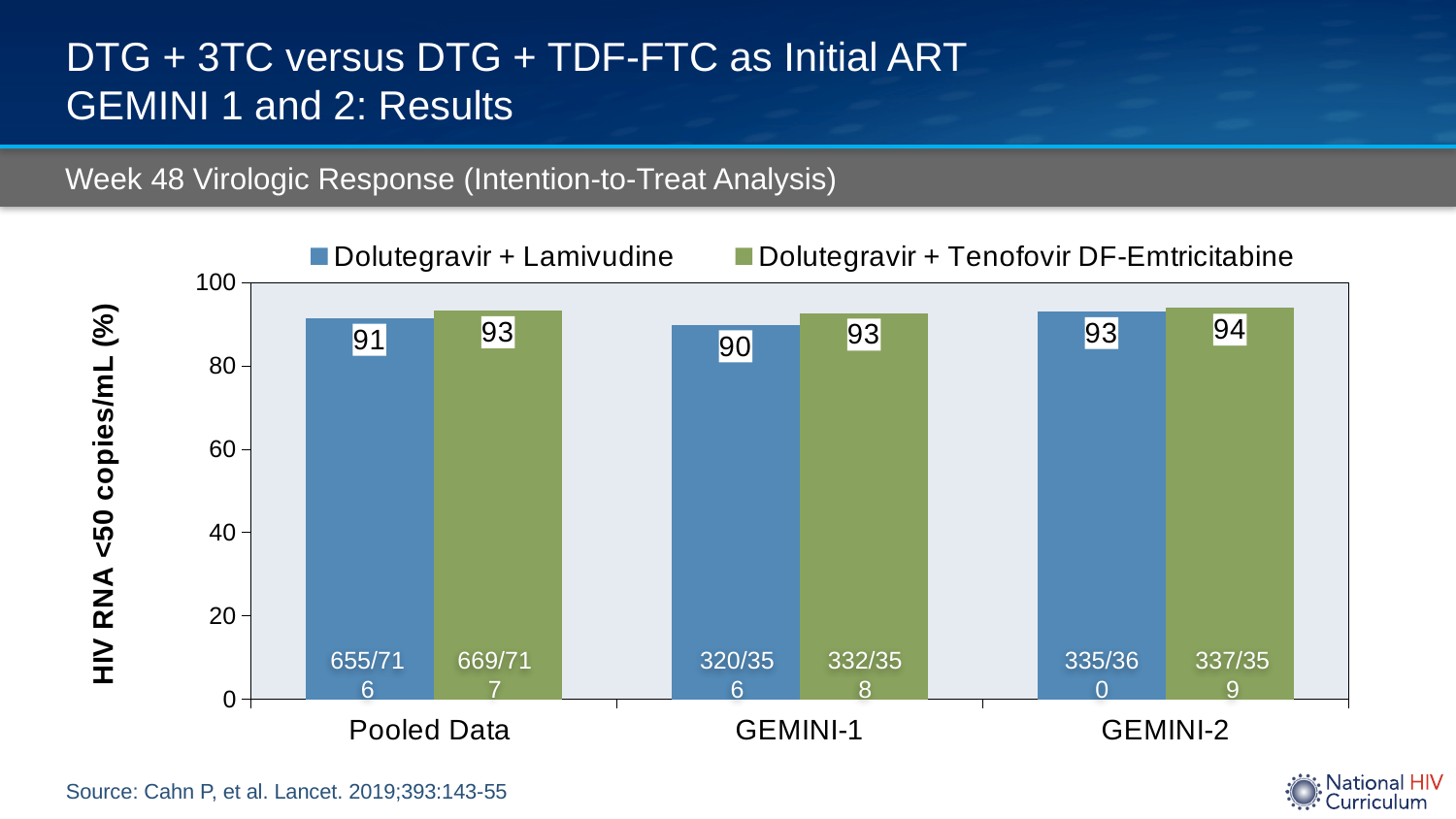
How many study groups are shown on the x axis? 3 Which study group has the lowest value for Dolutegravir + Lamivudine? GEMINI-1 Which bar has the highest value on the chart? Dolutegravir + Tenofovir DF-Emtricitabine in GEMINI-2 What kind of chart is shown on the slide? Bar chart In GEMINI-2, which series has the larger value? Dolutegravir + Tenofovir DF-Emtricitabine What is the difference between the two series' values in the Pooled Data group? 2 What is the value for Dolutegravir + Lamivudine in the Pooled Data group? 91 What is the value for Dolutegravir + Lamivudine in GEMINI-2? 93 How many series does the legend list? 2 What is the label of the y axis? HIV RNA <50 copies/mL (%) What is the value for Dolutegravir + Tenofovir DF-Emtricitabine in GEMINI-1? 93 What is the difference between the Dolutegravir + Tenofovir DF-Emtricitabine and Dolutegravir + Lamivudine values in GEMINI-1? 3